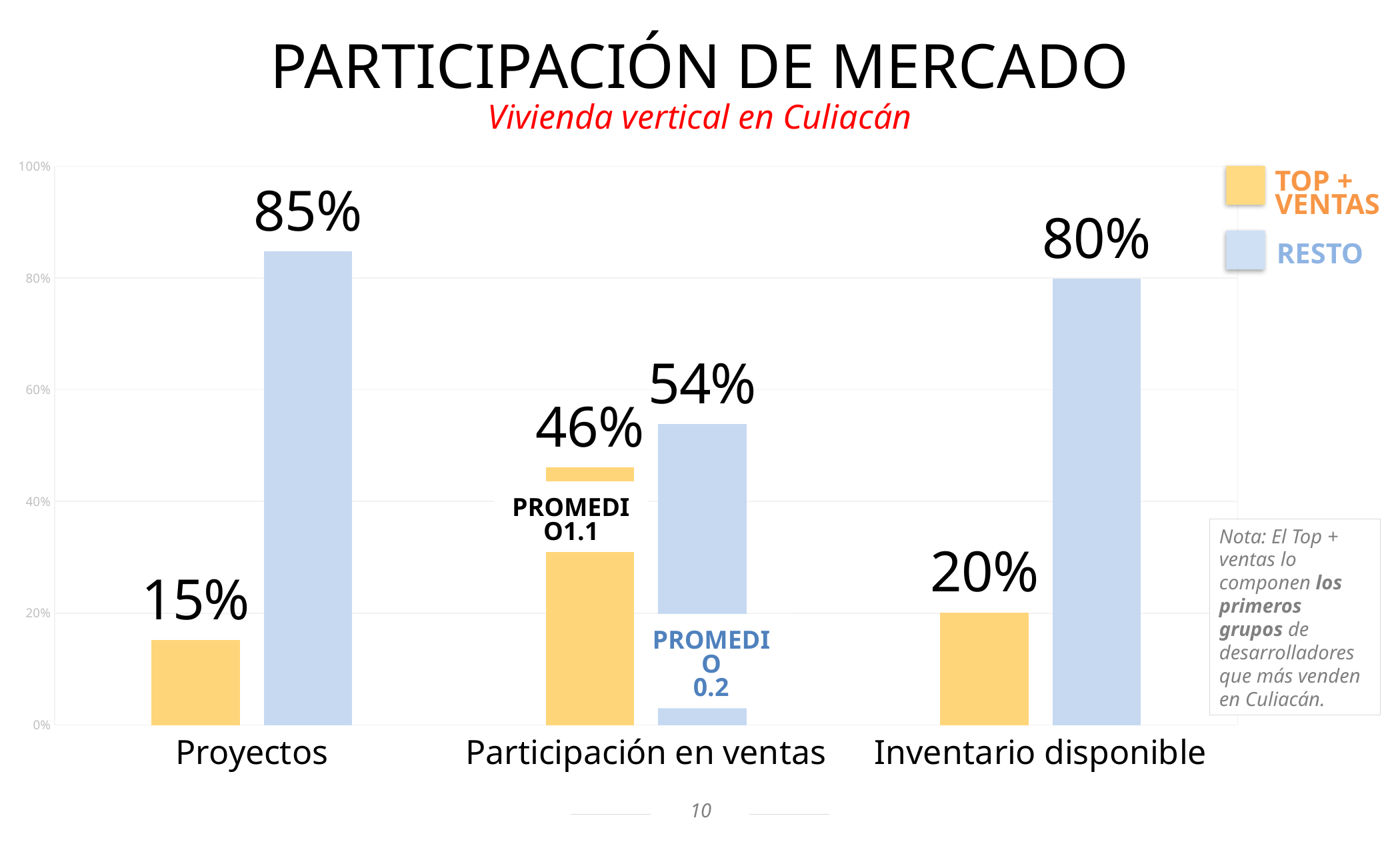
In which category is the RESTO value highest? Proyectos What kind of chart is shown on the slide? Bar chart What is the difference between the RESTO and TOP + VENTAS values in the Inventario disponible category? 60% What is the value for RESTO in the Proyectos category? 85% How many categories are shown on the x axis? 3 What is the value for RESTO in the Inventario disponible category? 80% Which is larger in the Participación en ventas category, TOP + VENTAS or RESTO? RESTO What is the subtitle shown in red below the chart title? Vivienda vertical en Culiacán How many series does the legend list? 2 In which category is the TOP + VENTAS value lowest? Proyectos What is the value for TOP + VENTAS in the Proyectos category? 15% What is the value for TOP + VENTAS in the Participación en ventas category? 46%